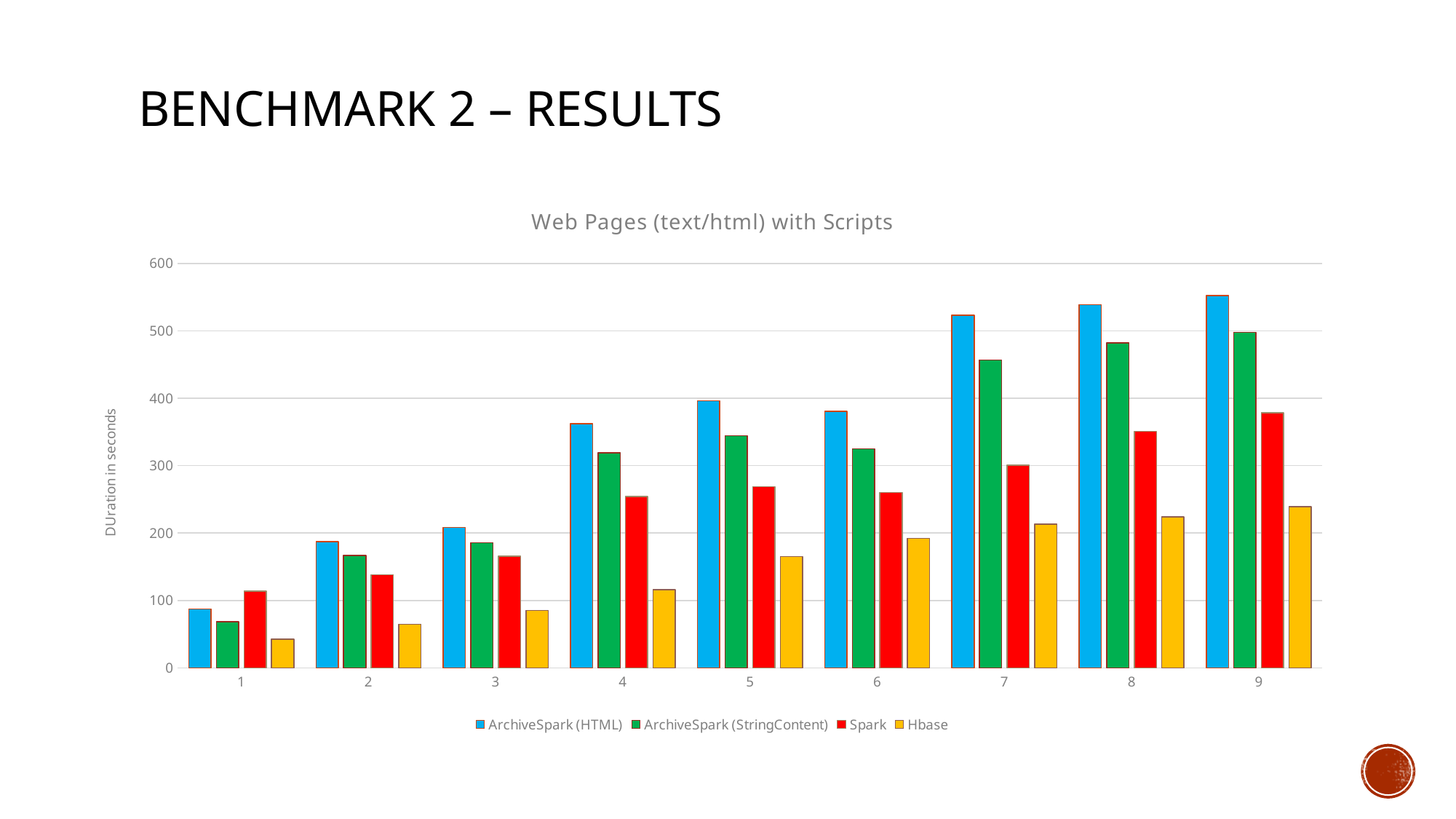
At category 1, which is larger: Spark or ArchiveSpark (HTML)? Spark Is the value for Spark at category 9 greater or less than 400? less Do the Hbase values rise or fall from category 1 to category 9? rise How many series does the legend list? 4 What kind of chart is shown on the slide? bar chart Which category has the highest value for ArchiveSpark (HTML)? 9 Is the value for Hbase at category 4 greater or less than 100? greater Is the value for ArchiveSpark (HTML) at category 7 greater or less than 500? greater How many categories are shown on the x axis? 9 Which colour represents the Spark series in the legend? red Which category has the lowest value for Hbase? 1 What is the title of the chart? Web Pages (text/html) with Scripts